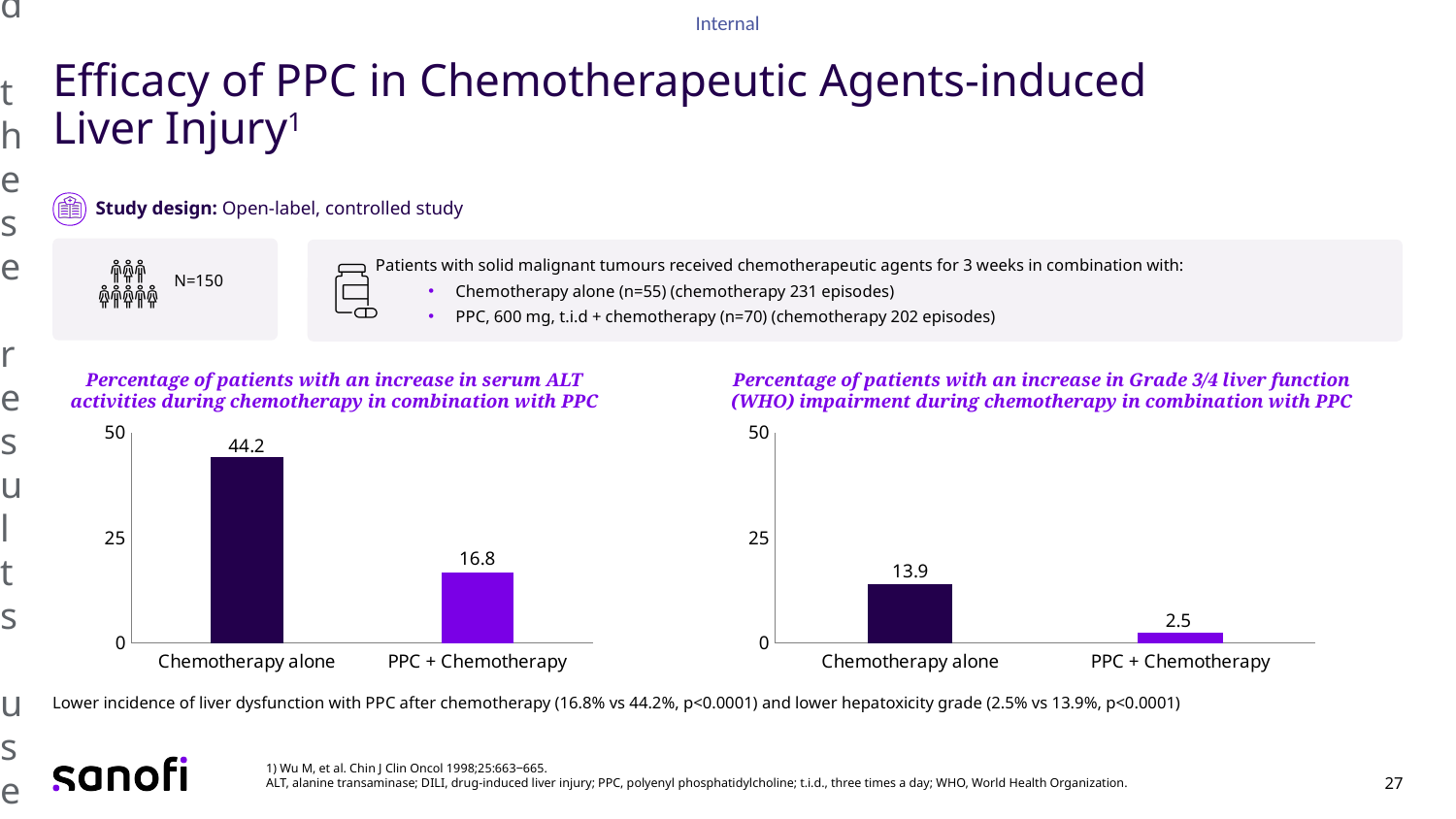
In the left chart, which category has the highest value? Chemotherapy alone In the left chart (Percentage of patients with an increase in serum ALT activities), what is the value for PPC + Chemotherapy? 16.8 In the left chart, is the value for Chemotherapy alone greater or less than 25? greater In the left chart (Percentage of patients with an increase in serum ALT activities), what is the value for Chemotherapy alone? 44.2 How many categories are shown in the left chart? 2 In the right chart (Percentage of patients with an increase in Grade 3/4 liver function impairment), what is the value for Chemotherapy alone? 13.9 What type of chart is the right chart? Bar chart In the left chart, what is the difference between the values for Chemotherapy alone and PPC + Chemotherapy? 27.4 In the right chart, what is the difference between the values for Chemotherapy alone and PPC + Chemotherapy? 11.4 In the right chart, is the value for Chemotherapy alone greater or less than 25? less In the right chart (Percentage of patients with an increase in Grade 3/4 liver function impairment), what is the value for PPC + Chemotherapy? 2.5 In the right chart, which category has the lowest value? PPC + Chemotherapy